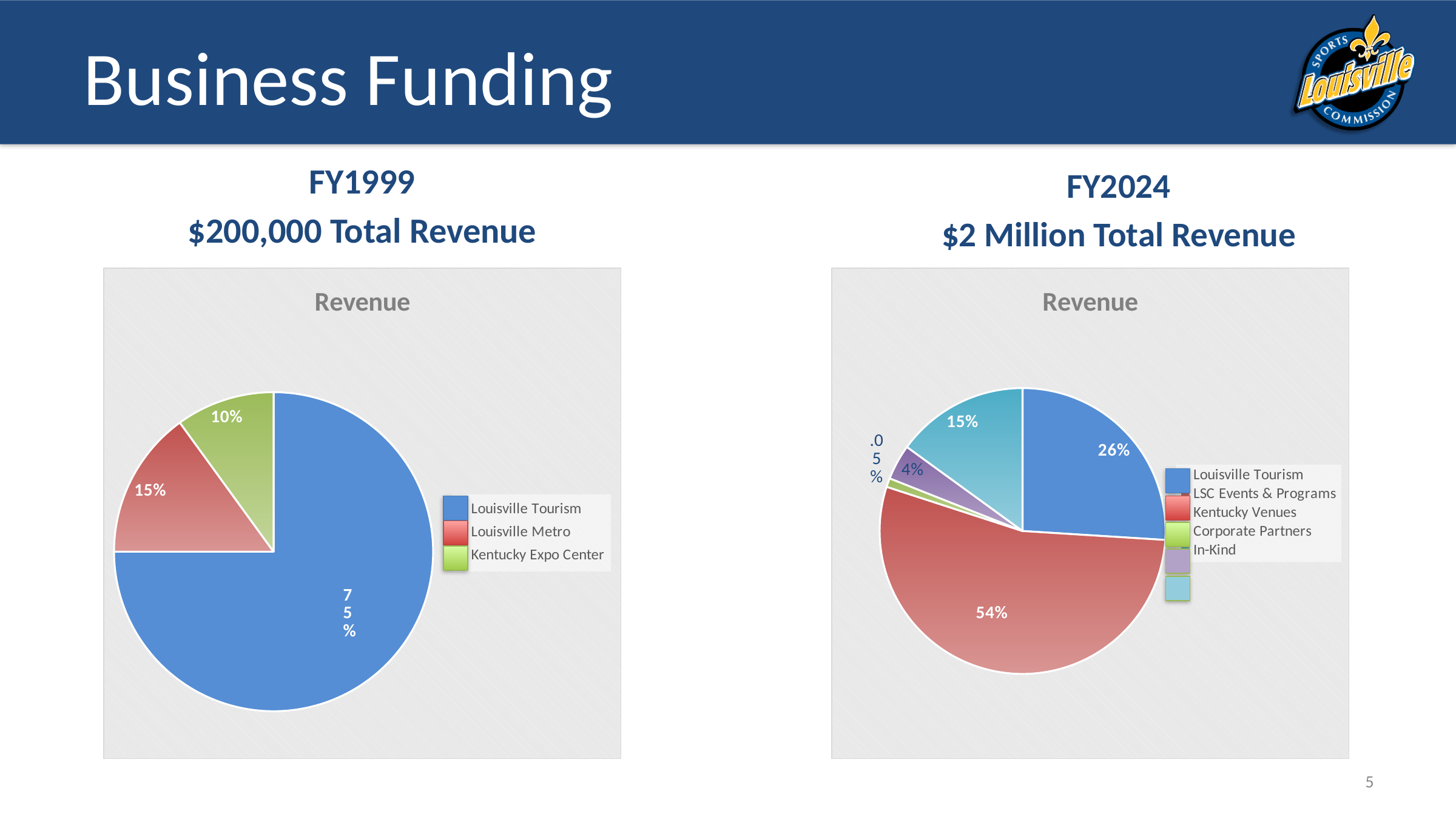
In the FY1999 chart, which source has the smallest share of revenue? Kentucky Expo Center What kind of chart is shown under the FY1999 heading? pie chart In the FY1999 chart, how many percentage points larger is Louisville Tourism's share than Louisville Metro's? 60 In the FY1999 chart, what share of revenue comes from Kentucky Expo Center? 10% In the FY1999 chart, what share of revenue comes from Louisville Metro? 15% In the FY1999 chart, which source has the largest share of revenue? Louisville Tourism In the FY1999 chart, what share of revenue comes from Louisville Tourism? 75% How many categories does the legend of the FY1999 chart list? 3 What total revenue is stated above the FY2024 chart? $2 Million Total Revenue What total revenue is stated above the FY1999 chart? $200,000 Total Revenue In the FY2024 chart, what is the share of the largest slice? 54%